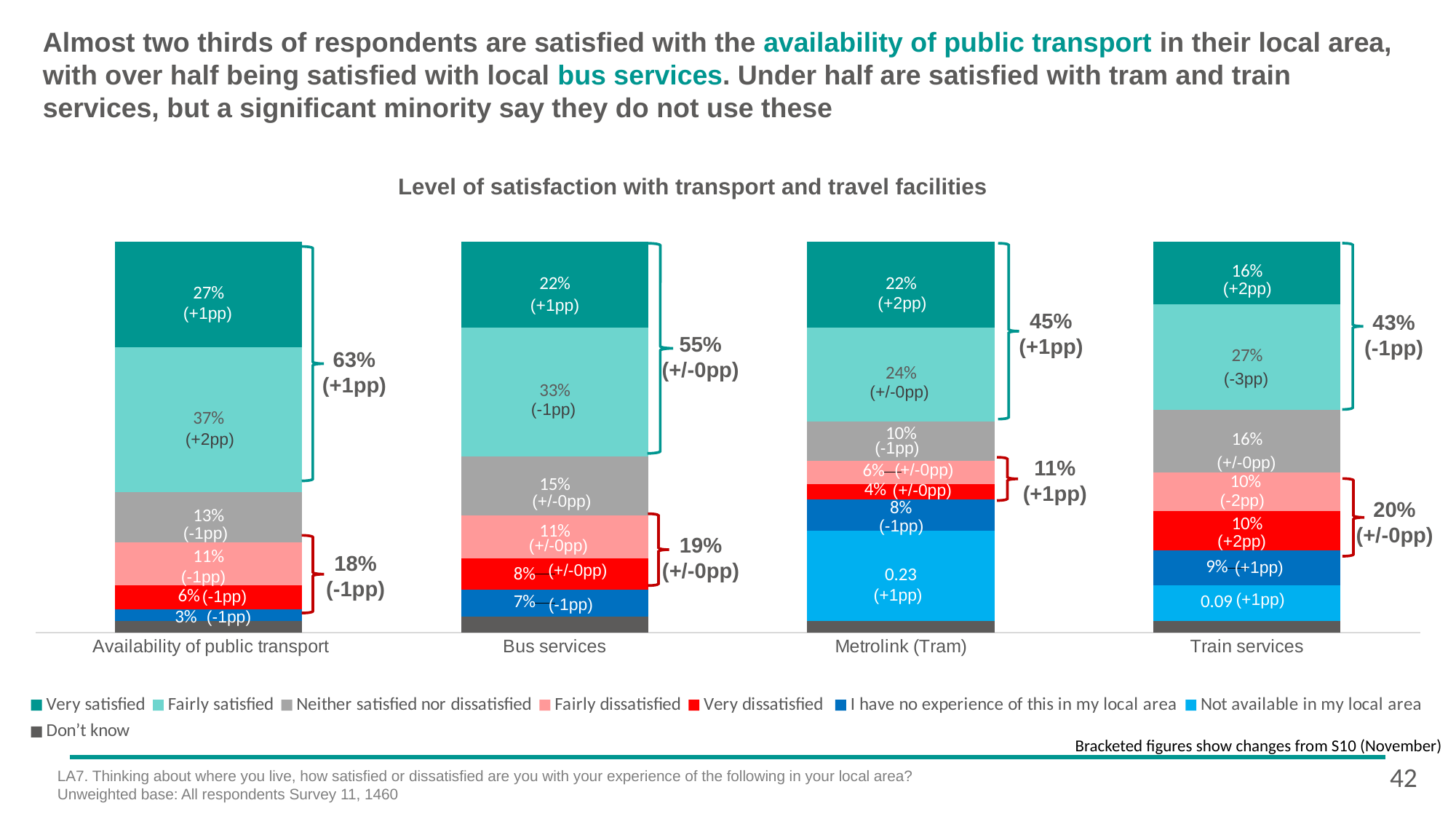
What percentage of respondents are very satisfied with the availability of public transport? 27% What is the combined very satisfied and fairly satisfied total for Train services? 43% What value is shown for 'Not available in my local area' for Metrolink (Tram)? 0.23 Which has a larger 'Neither satisfied nor dissatisfied' share, Bus services or Train services? Train services What is the difference between the very satisfied percentage for Availability of public transport and for Train services? 11% How many series does the legend list? 8 What is the title of the chart? Level of satisfaction with transport and travel facilities How many categories are shown on the x axis of the chart? 4 Which category has the highest very satisfied percentage? Availability of public transport What kind of chart is shown on the slide? Stacked bar chart Which category has the lowest fairly satisfied percentage? Metrolink (Tram) What is the fairly satisfied value for Bus services? 33%